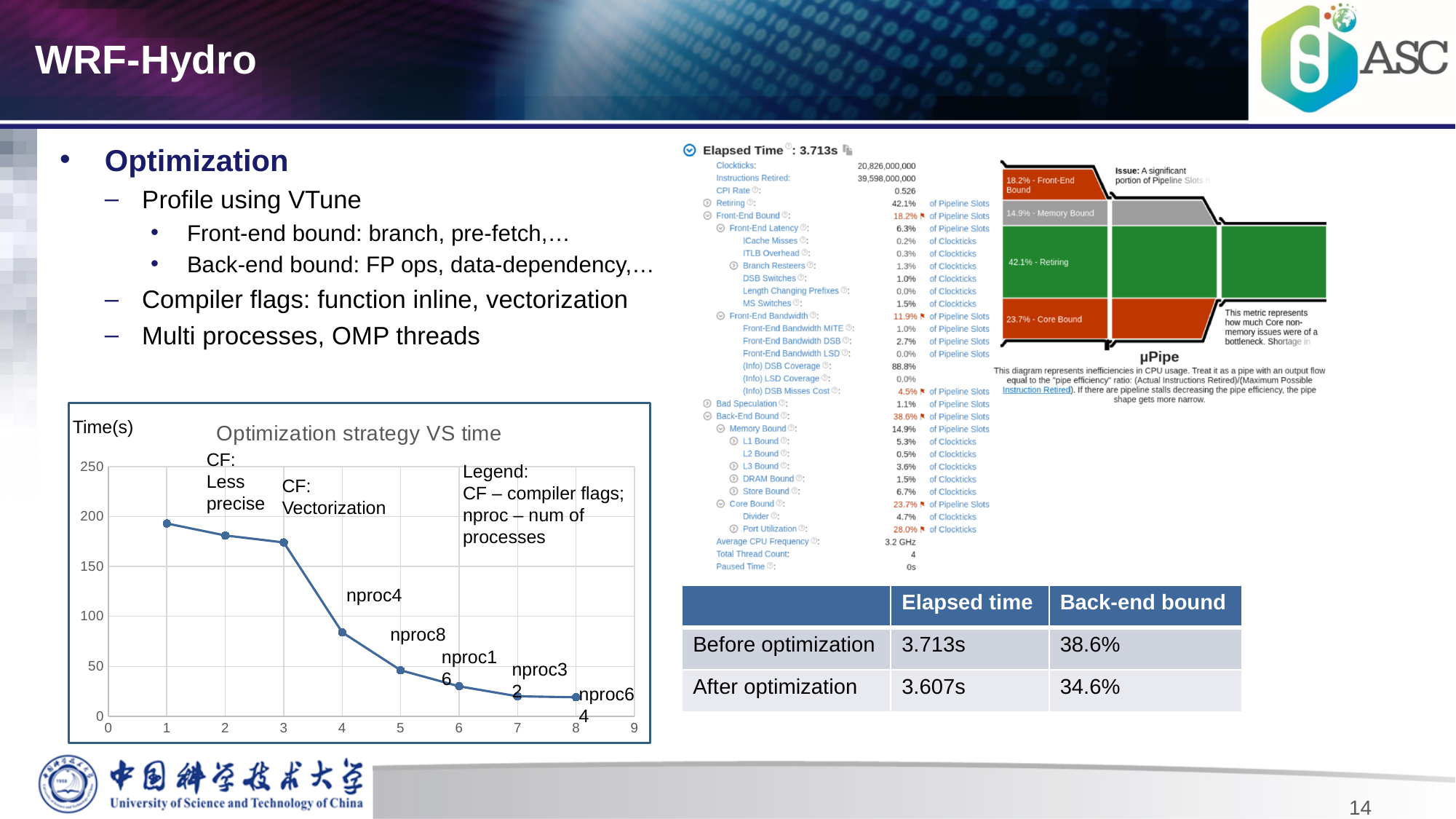
Is the value at x = 1 greater or less than 150? greater How many data points are plotted on the line in the chart? 8 Do the values in the chart rise or fall as you move along the x axis? fall Is the value at x = 8 greater or less than 50? less Is the value at x = 3 greater or less than 150? greater Which has the larger plotted time, the point at x = 1 or the point at x = 4? x = 1 What kind of chart is shown on the slide? line chart At which x-axis position is the plotted time highest? 1 What is the title of the chart on the slide? Optimization strategy VS time What is the label on the vertical axis of the chart? Time(s)